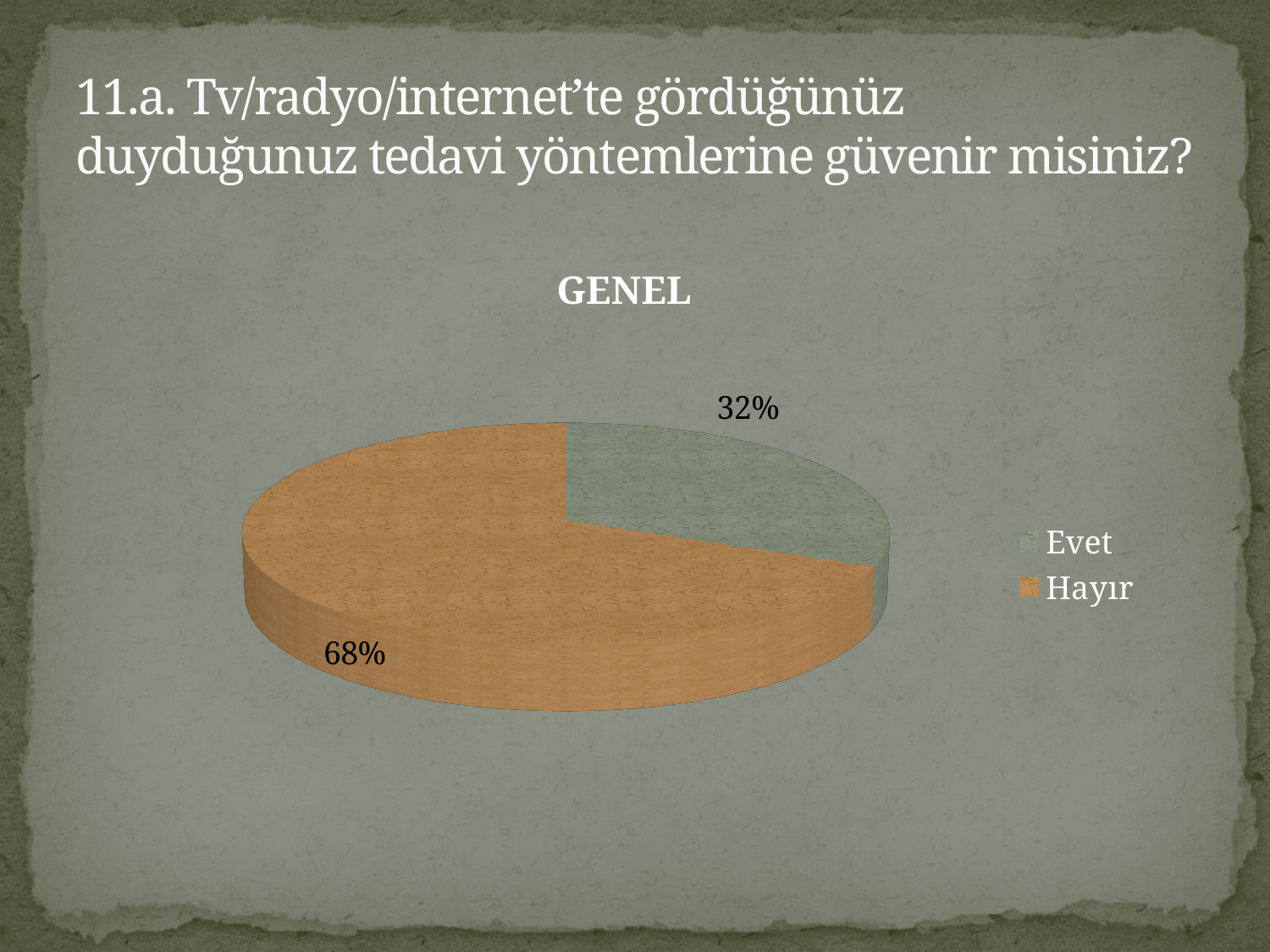
What is the difference in percentage points between Hayır and Evet? 36 What share of the pie does Evet represent? 32% Which category is shown in orange in the pie chart? Hayır Which category has the largest slice of the pie? Hayır How many categories are shown in the pie chart? 2 What share of the pie does Hayır represent? 68% How many entries does the legend list? 2 Which category has the smallest slice of the pie? Evet Which is larger, the share for Evet or the share for Hayır? Hayır What kind of chart is shown on the slide? Pie chart What is the title of the chart? GENEL